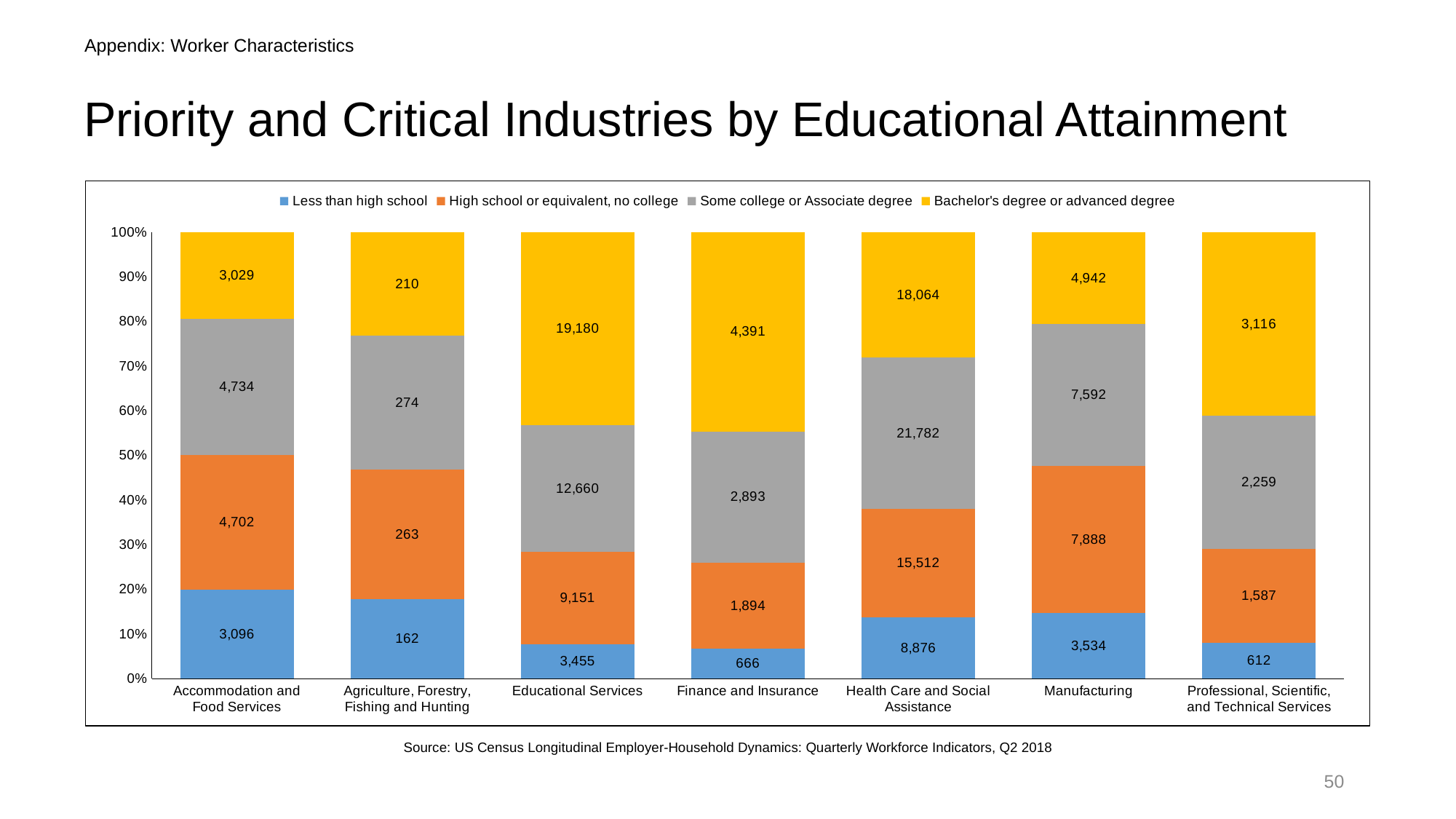
Which industry has the highest value for Bachelor's degree or advanced degree? Educational Services Which industry has the lowest value for Less than high school? Agriculture, Forestry, Fishing and Hunting What kind of chart is shown on the slide? Stacked bar chart Is the share of Less than high school in Accommodation and Food Services greater or less than 10%? greater How many industries are shown on the x axis? 7 How many educational attainment series does the legend list? 4 What is the value for Less than high school in Health Care and Social Assistance? 8,876 What is the total of all four segments for Agriculture, Forestry, Fishing and Hunting? 909 What is the value for High school or equivalent, no college in Manufacturing? 7,888 What is the difference between the Bachelor's degree or advanced degree value and the Some college or Associate degree value in Educational Services? 6,520 What is the value for Bachelor's degree or advanced degree in Educational Services? 19,180 Which is larger in Health Care and Social Assistance: Some college or Associate degree or Bachelor's degree or advanced degree? Some college or Associate degree